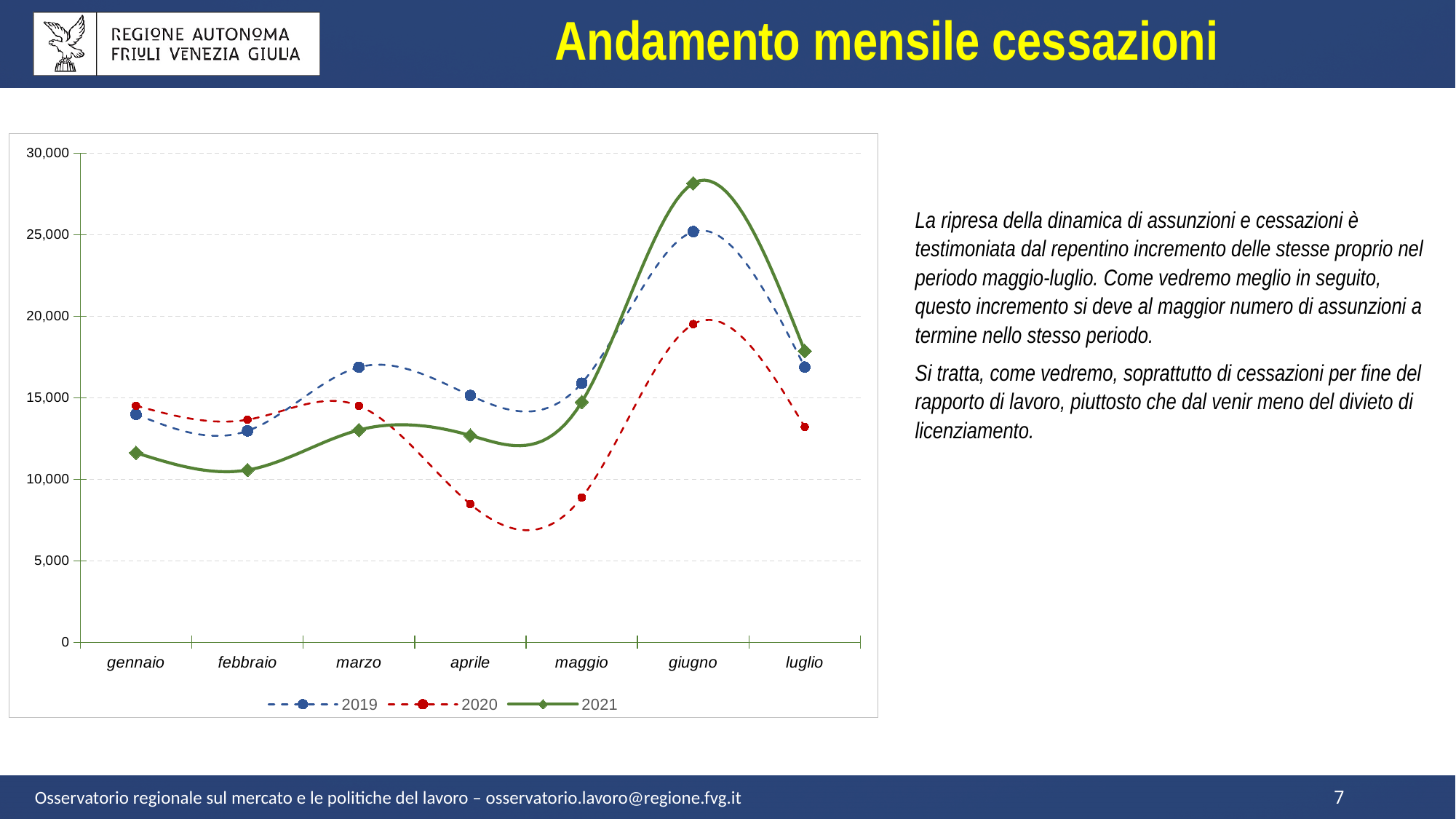
In which month does the 2021 series reach its lowest value? febbraio How many months are shown on the x axis of the chart? 7 Does the 2020 series rise or fall from marzo to aprile? fall How many series does the chart legend list? 3 In giugno, which series has the higher value, 2019 or 2021? 2021 In which month does the 2020 series reach its lowest value? aprile What is the title of the slide containing the chart? Andamento mensile cessazioni In which month does the 2021 series reach its highest value? giugno In gennaio, which series has the higher value, 2019 or 2021? 2019 Is the value for 2020 in aprile greater or less than 10,000? less Is the value for 2021 in giugno greater or less than 25,000? greater What kind of chart is shown on the slide? line chart